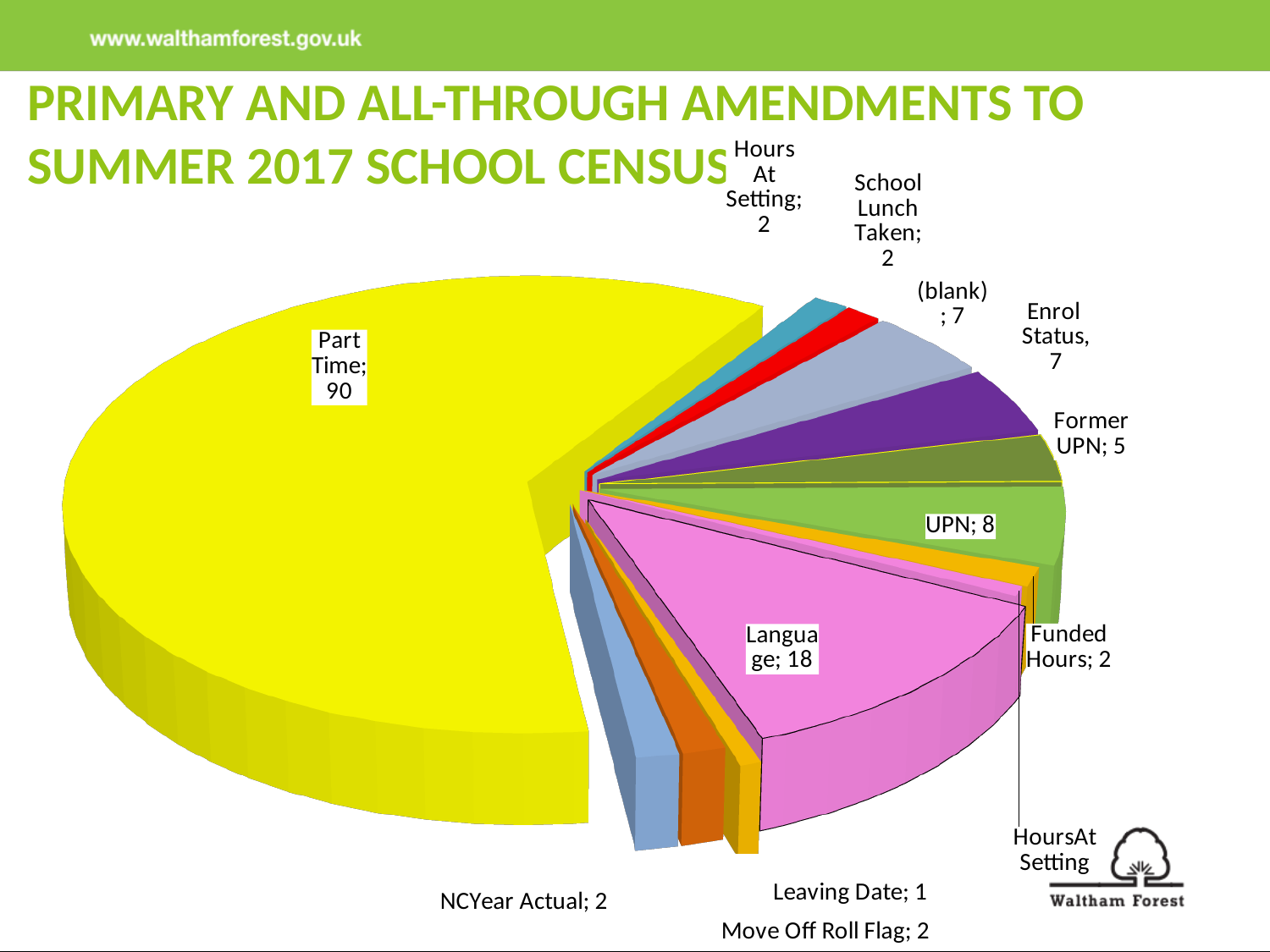
What kind of chart is shown on the slide? pie chart Which is larger, the value for UPN or the value for Former UPN? UPN Which category has the smallest value shown? Leaving Date What is the value for Former UPN? 5 What is the value for Leaving Date? 1 What is the value for Language? 18 What is the difference between the values for Part Time and Language? 72 What is the value for Part Time? 90 What is the difference between the values for Language and UPN? 10 What is the value for UPN? 8 What is the value for Enrol Status? 7 Which category has the largest slice of the pie? Part Time